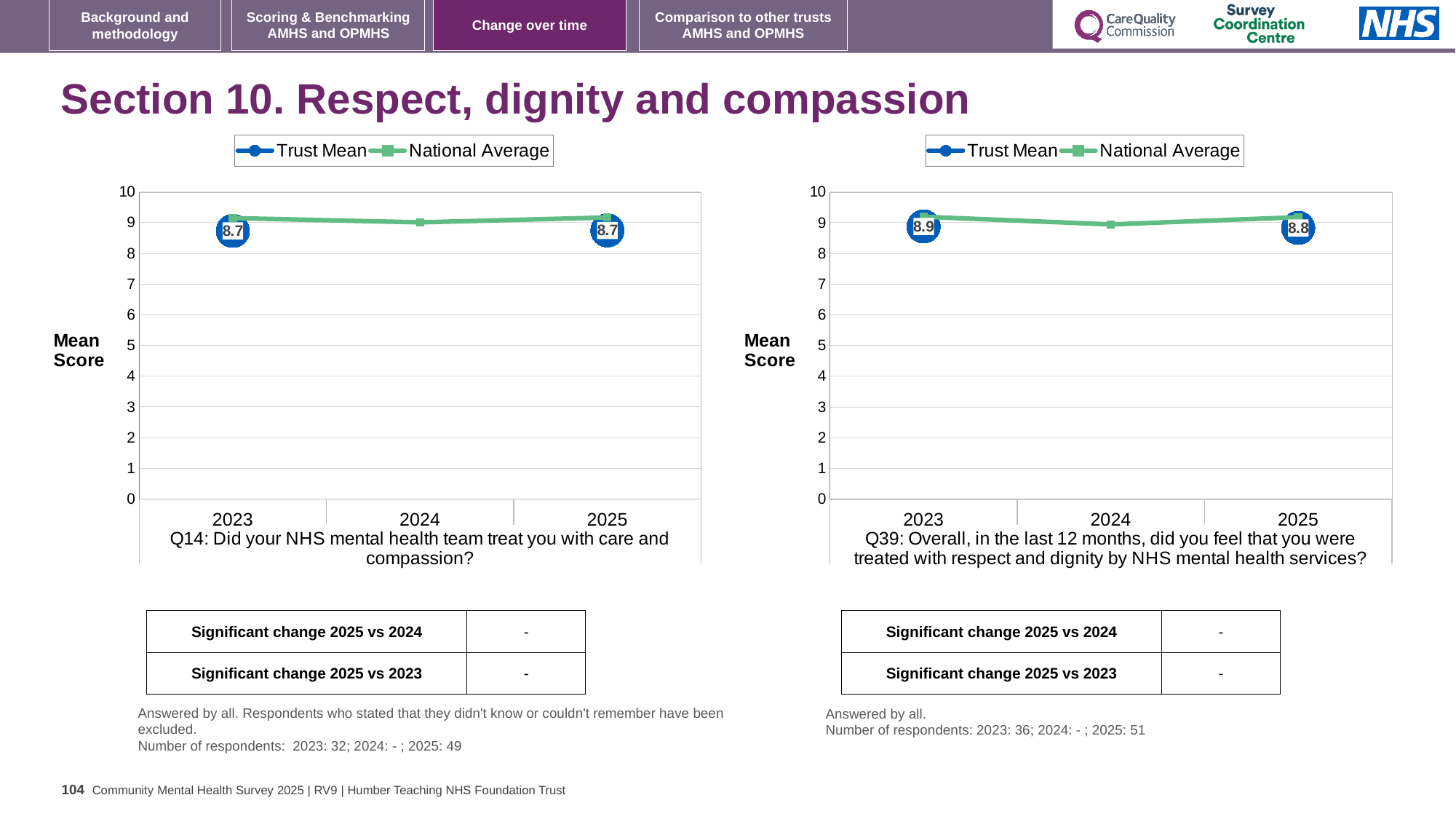
In the right chart (Q39), what is the Trust Mean for 2025? 8.8 In the right chart (Q39), which year has the higher Trust Mean, 2023 or 2025? 2023 What kind of chart is the left chart (Q14)? Line chart How many years are shown on the x axis of the left chart (Q14)? 3 In the left chart (Q14), is the National Average value for 2024 greater or less than 8? greater In the right chart (Q39), what is the difference between the Trust Mean for 2023 and the Trust Mean for 2025? 0.1 In the left chart (Q14), what is the difference between the Trust Mean for 2023 and the Trust Mean for 2025? 0 What is the y-axis title of the right chart (Q39)? Mean Score How many series does the legend of the right chart (Q39) list? 2 In the left chart (Q14), what is the Trust Mean for 2025? 8.7 In the right chart (Q39), what is the Trust Mean for 2023? 8.9 In the left chart (Q14), what is the Trust Mean for 2023? 8.7